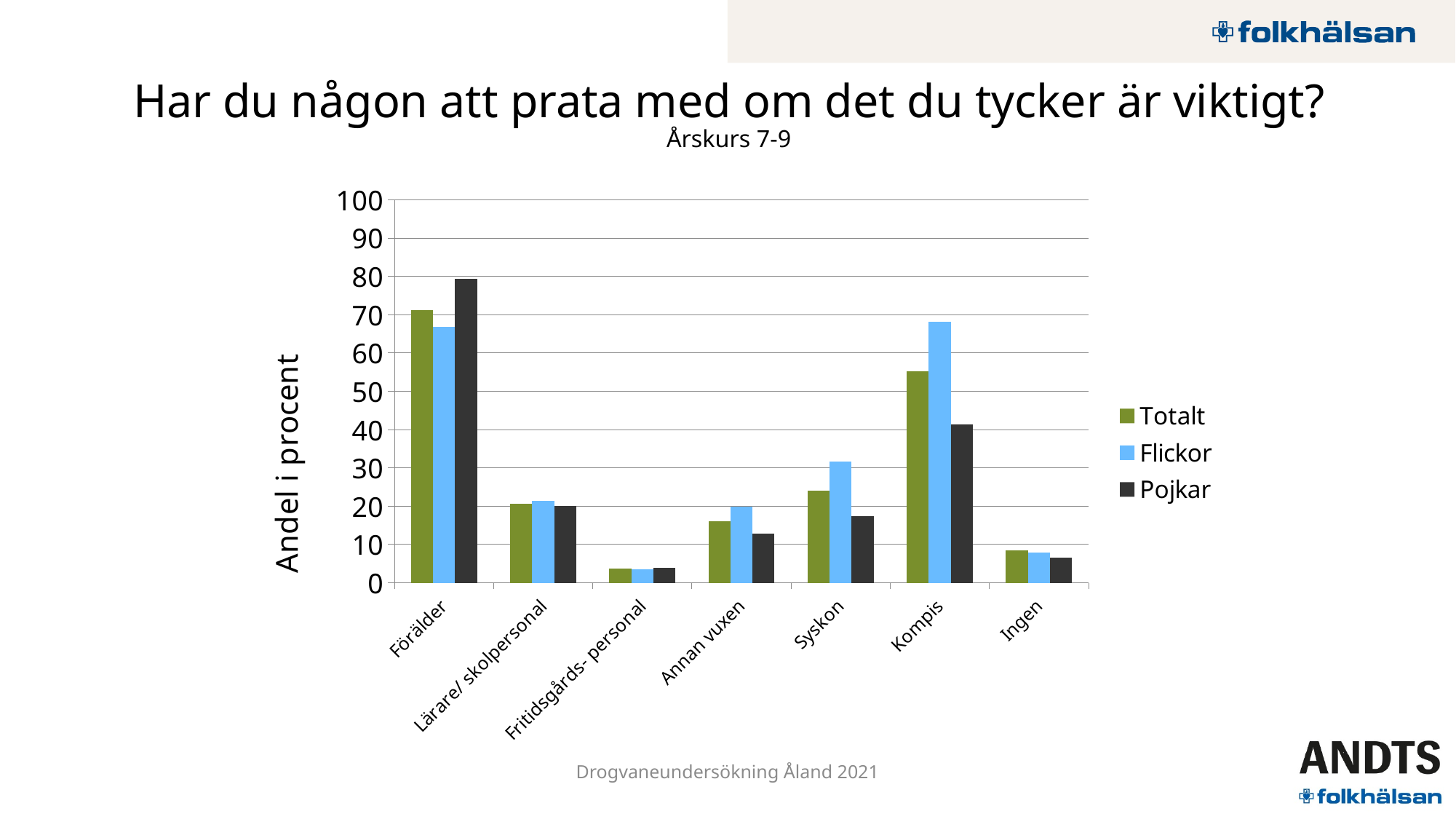
For Kompis, which is larger: Flickor or Pojkar? Flickor Which category has the highest value for Pojkar? Förälder For Förälder, which is larger: Pojkar or Flickor? Pojkar Which category has the lowest value for Totalt? Fritidsgårds- personal Is the value for Totalt in the Förälder category greater or less than 60? greater Is the value for Flickor in the Kompis category greater or less than 60? greater What kind of chart is shown on the slide? bar chart Is the value for Pojkar in the Syskon category greater or less than 20? less What is the label on the y axis? Andel i procent How many series does the legend list? 3 How many categories are shown along the x axis? 7 What are the three series listed in the legend? Totalt, Flickor, Pojkar